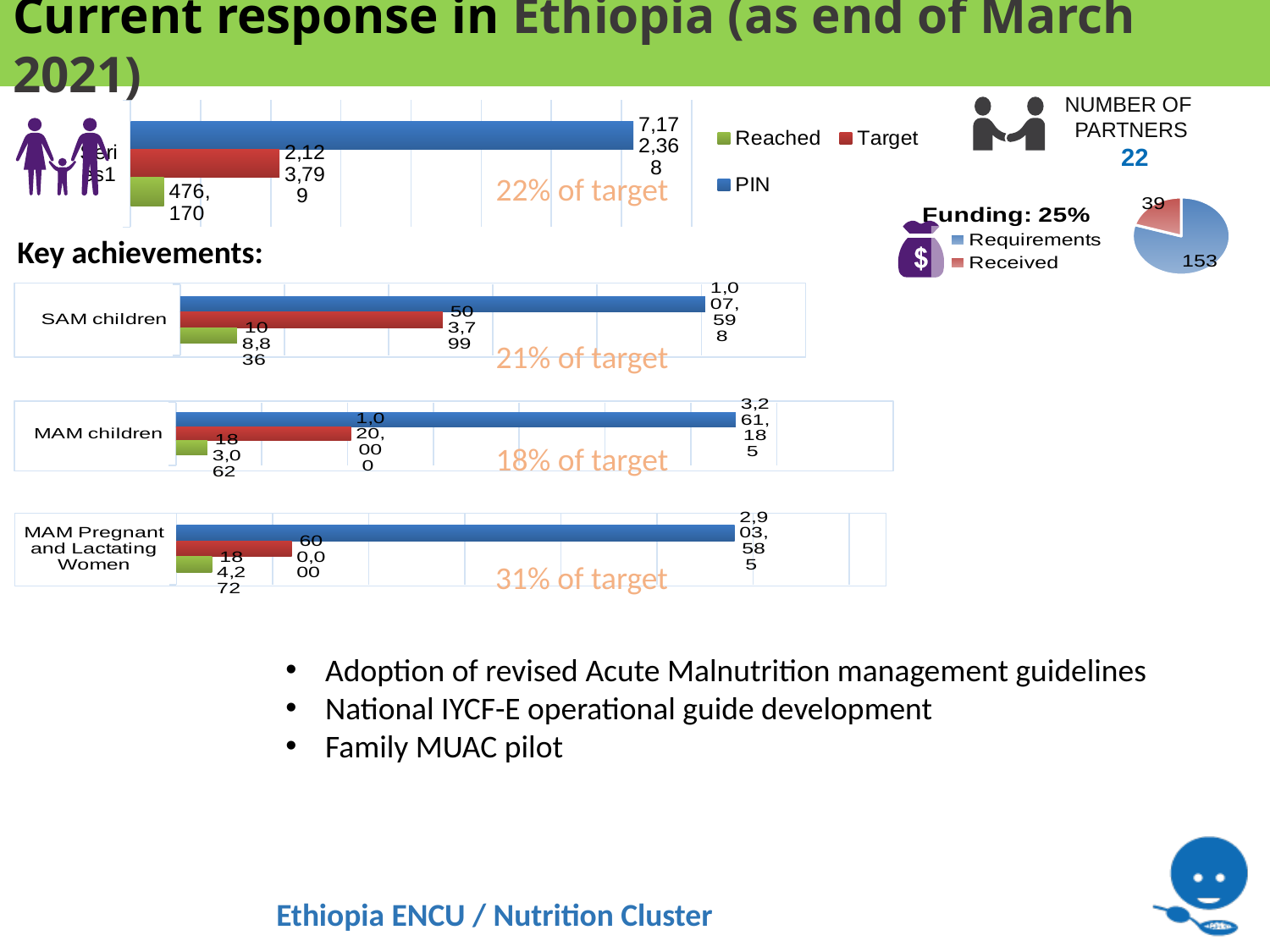
In the SAM children chart, what is the value for Target? 503,799 In the MAM Pregnant and Lactating Women chart, which series has the lowest value? Reached In the MAM children chart, which series has the highest value? PIN In the top bar chart, what is the value for Reached? 476,170 What kind of chart is the Funding chart? Pie chart In the SAM children chart, which is larger, Target or Reached? Target In the Funding pie chart, what is the value for Received? 39 In the MAM children chart, what is the value for Reached? 183,062 In the SAM children chart, what is the value for PIN? 1,007,598 In the Funding pie chart, what is the value for Requirements? 153 In the MAM Pregnant and Lactating Women chart, what is the value for Target? 600,000 How many series does the legend of the top bar chart list? 3